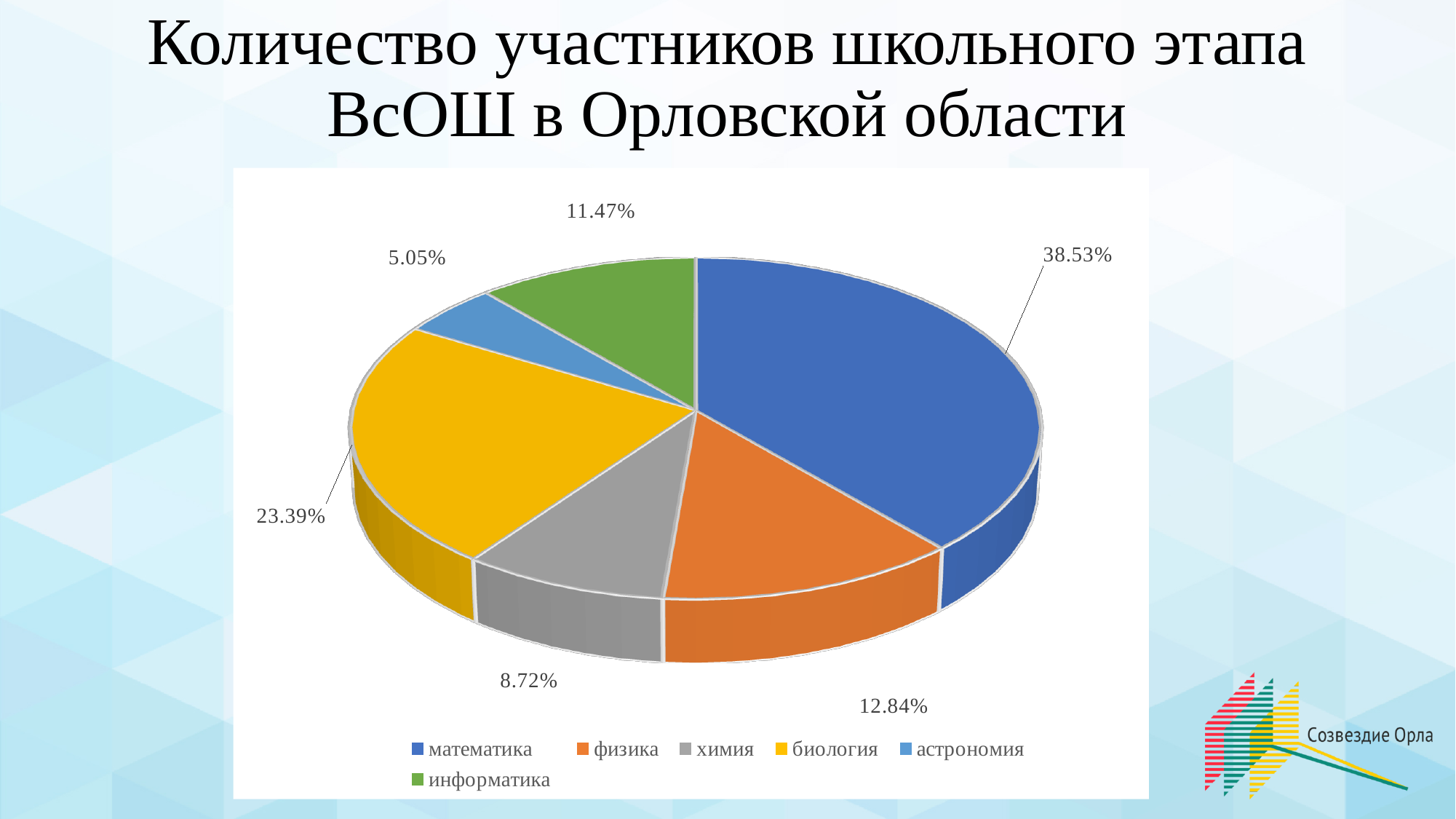
What share of the pie does физика have? 12.84% What share of the pie does информатика have? 11.47% What kind of chart is shown on the slide? pie chart What is the difference in percentage points between математика and биология? 15.14 What colour is the slice for биология? yellow What share of the pie does математика have? 38.53% Which subject has the smallest share of the pie? астрономия Which subject has the largest share of the pie? математика How many subjects are shown in the pie chart? 6 Which has a larger share, физика or химия? физика